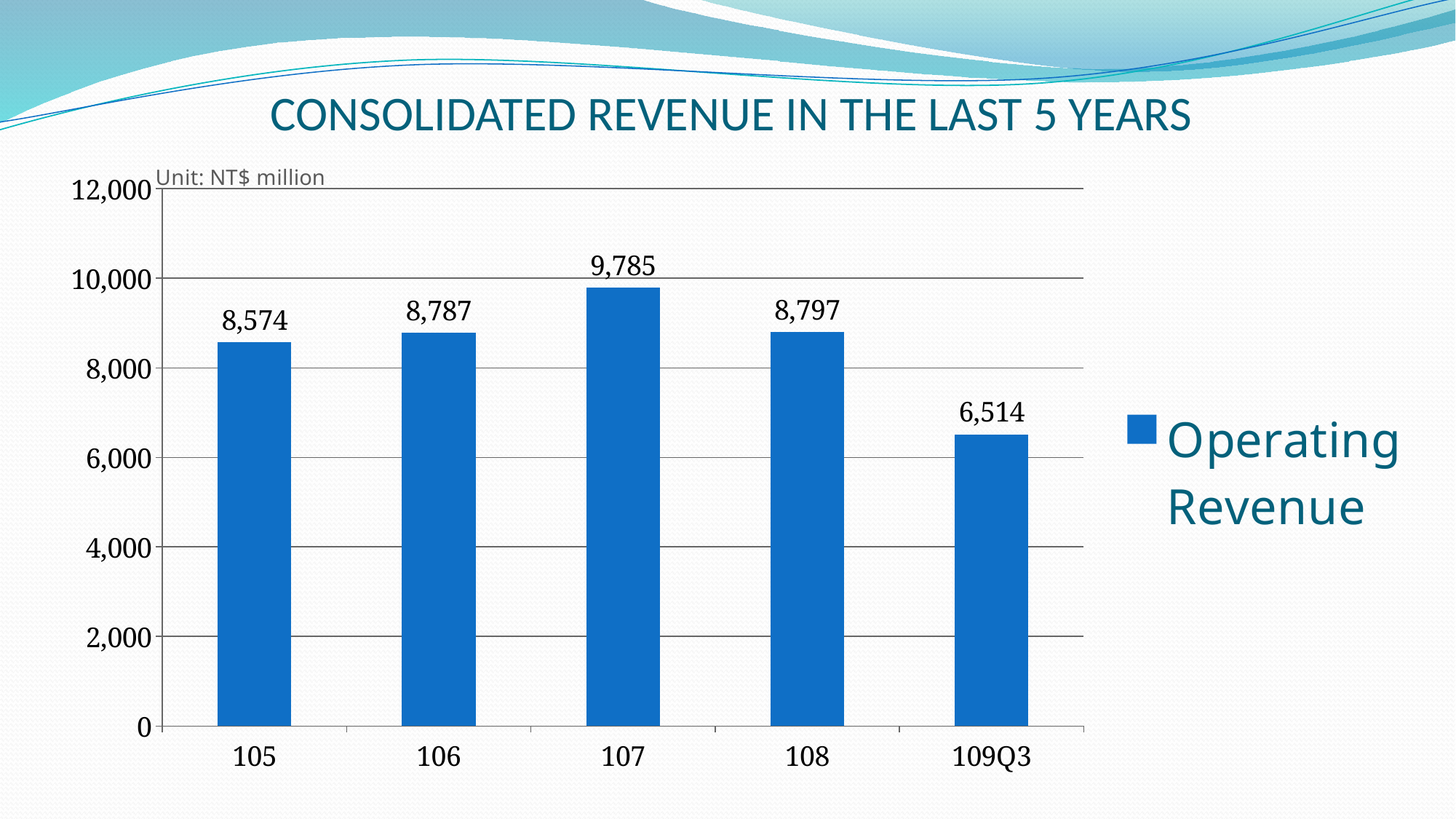
What is the difference between the Operating Revenue for 106 and 105? 213 What is the Operating Revenue for 107? 9,785 Which category has the lowest Operating Revenue? 109Q3 What unit is stated for the values in the chart? NT$ million What is the Operating Revenue for 109Q3? 6,514 What is the Operating Revenue for 105? 8,574 Which has a larger Operating Revenue, 105 or 107? 107 What kind of chart is shown on the slide? bar chart Which category has the highest Operating Revenue? 107 What is the difference between the Operating Revenue for 107 and 108? 988 Is the Operating Revenue for 109Q3 greater or less than 8,000? less How many categories are shown on the x axis? 5